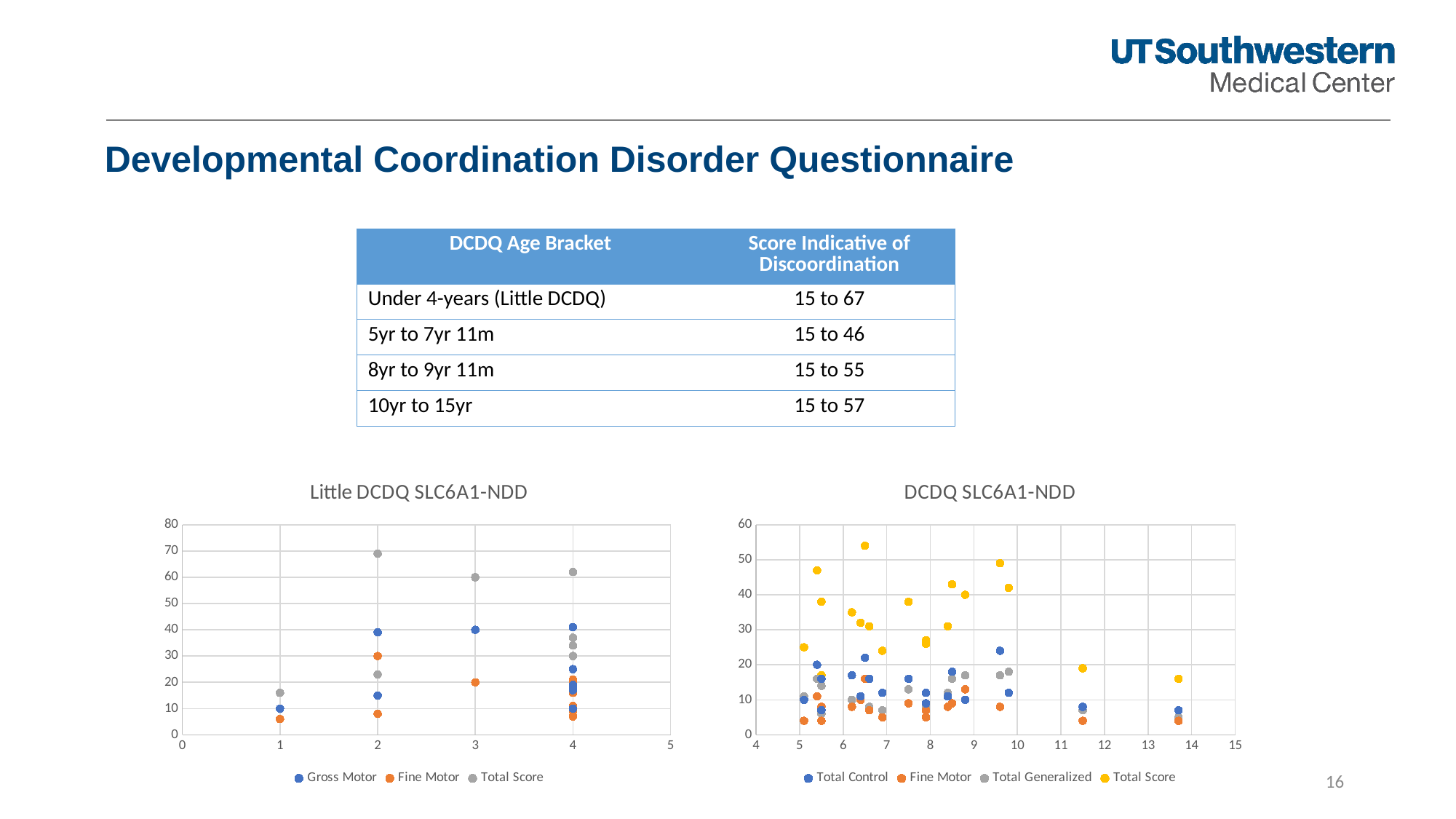
What kind of chart is the left chart titled "Little DCDQ SLC6A1-NDD"? scatter chart In the left chart "Little DCDQ SLC6A1-NDD", how many distinct x positions have plotted points? 4 In the right chart "DCDQ SLC6A1-NDD", what colour are the Total Score points? yellow In the right chart "DCDQ SLC6A1-NDD", is the highest Total Score point greater or less than 50? greater In the left chart "Little DCDQ SLC6A1-NDD", is the Fine Motor value at x = 1 greater or less than 10? less What is the title of the right chart? DCDQ SLC6A1-NDD In the left chart "Little DCDQ SLC6A1-NDD", which series contains the highest plotted point? Total Score In the right chart "DCDQ SLC6A1-NDD", which series contains the highest plotted point? Total Score In the left chart "Little DCDQ SLC6A1-NDD", at x = 2, which is larger: the Total Score point or the Gross Motor point? Total Score How many series does the legend of the right chart "DCDQ SLC6A1-NDD" list? 4 How many series does the legend of the left chart "Little DCDQ SLC6A1-NDD" list? 3